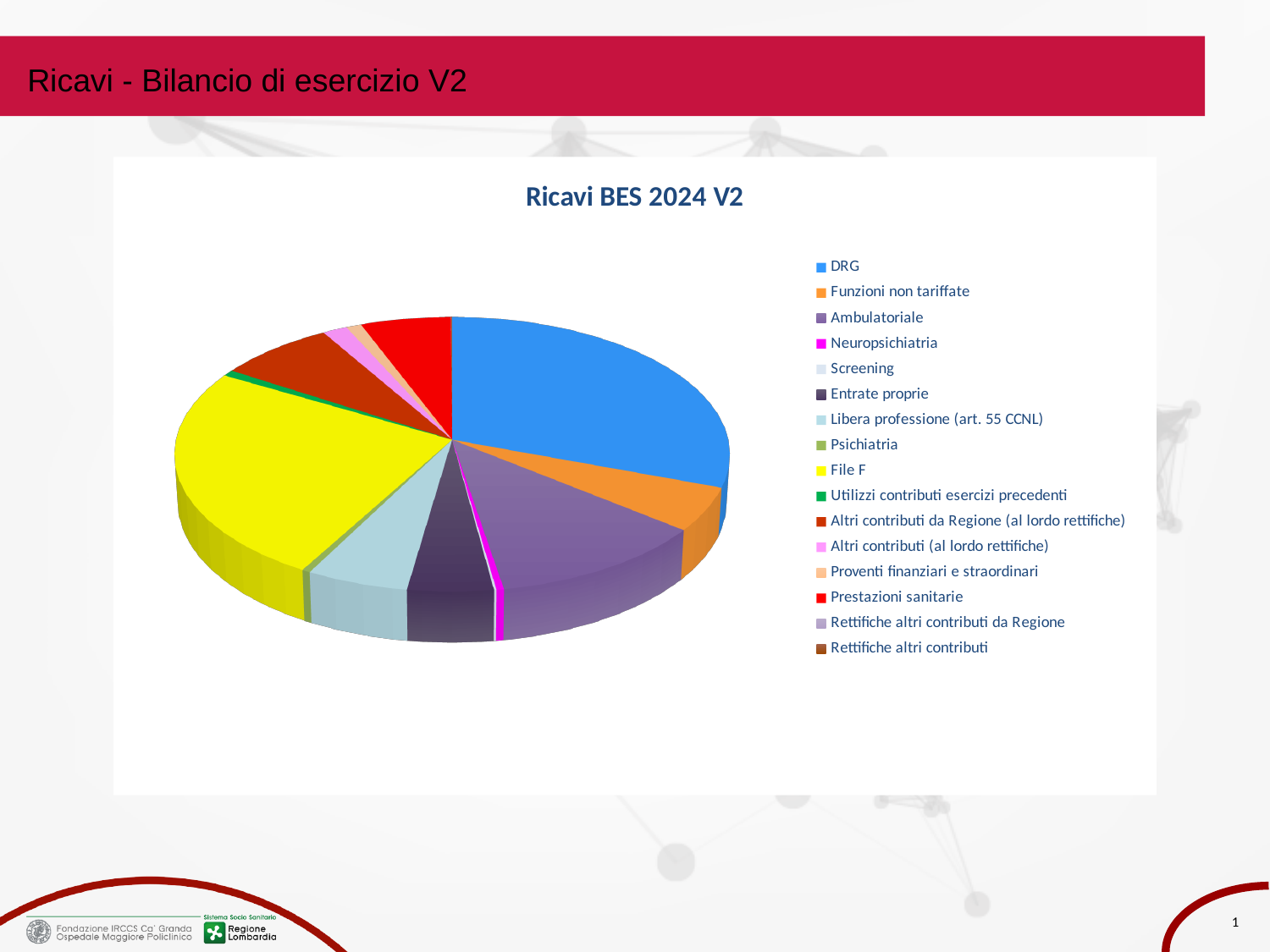
Which slice is larger, Prestazioni sanitarie or Neuropsichiatria? Prestazioni sanitarie Which slice is larger, File F or Ambulatoriale? File F What colour is the File F slice in the pie chart? Yellow Which slice is larger, File F or Libera professione (art. 55 CCNL)? File F Which category has the largest slice of the pie? DRG How many categories does the legend of the pie chart list? 16 What is the title of the chart? Ricavi BES 2024 V2 What kind of chart is shown on the slide? Pie chart